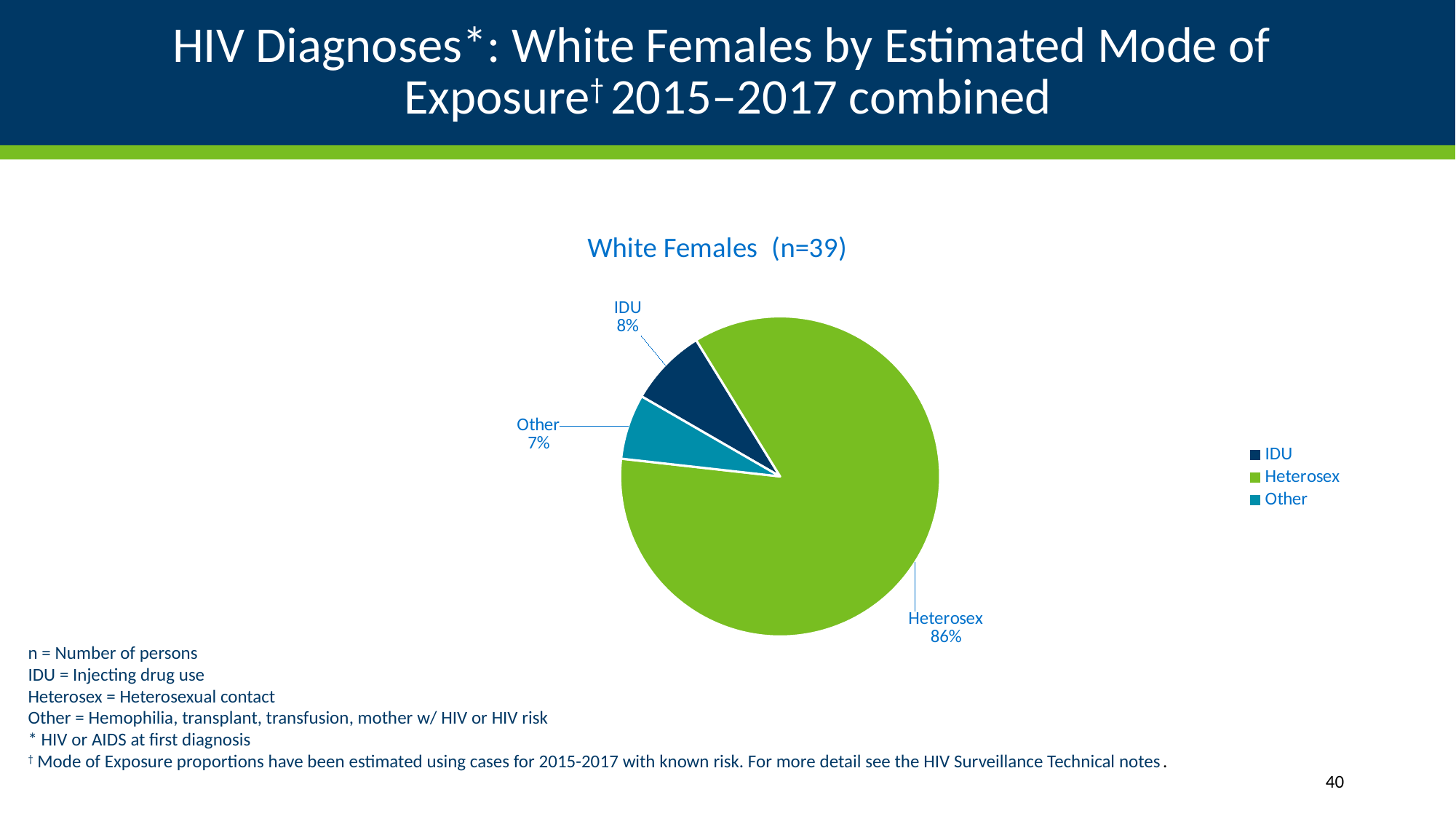
Which slice is larger, IDU or Heterosex? Heterosex What is the value of n shown in the chart title? 39 Which mode of exposure has the smallest share of the pie? Other How many slices does the pie chart have? 3 What is the difference in percentage points between the Heterosex and IDU slices? 78 What is the difference in percentage points between the IDU and Other slices? 1 What percentage of the pie is Other? 7% What kind of chart is shown on the slide? Pie chart What percentage of the pie is Heterosex? 86% What percentage of the pie is IDU? 8% Which mode of exposure has the largest share of the pie? Heterosex How many entries does the legend list? 3